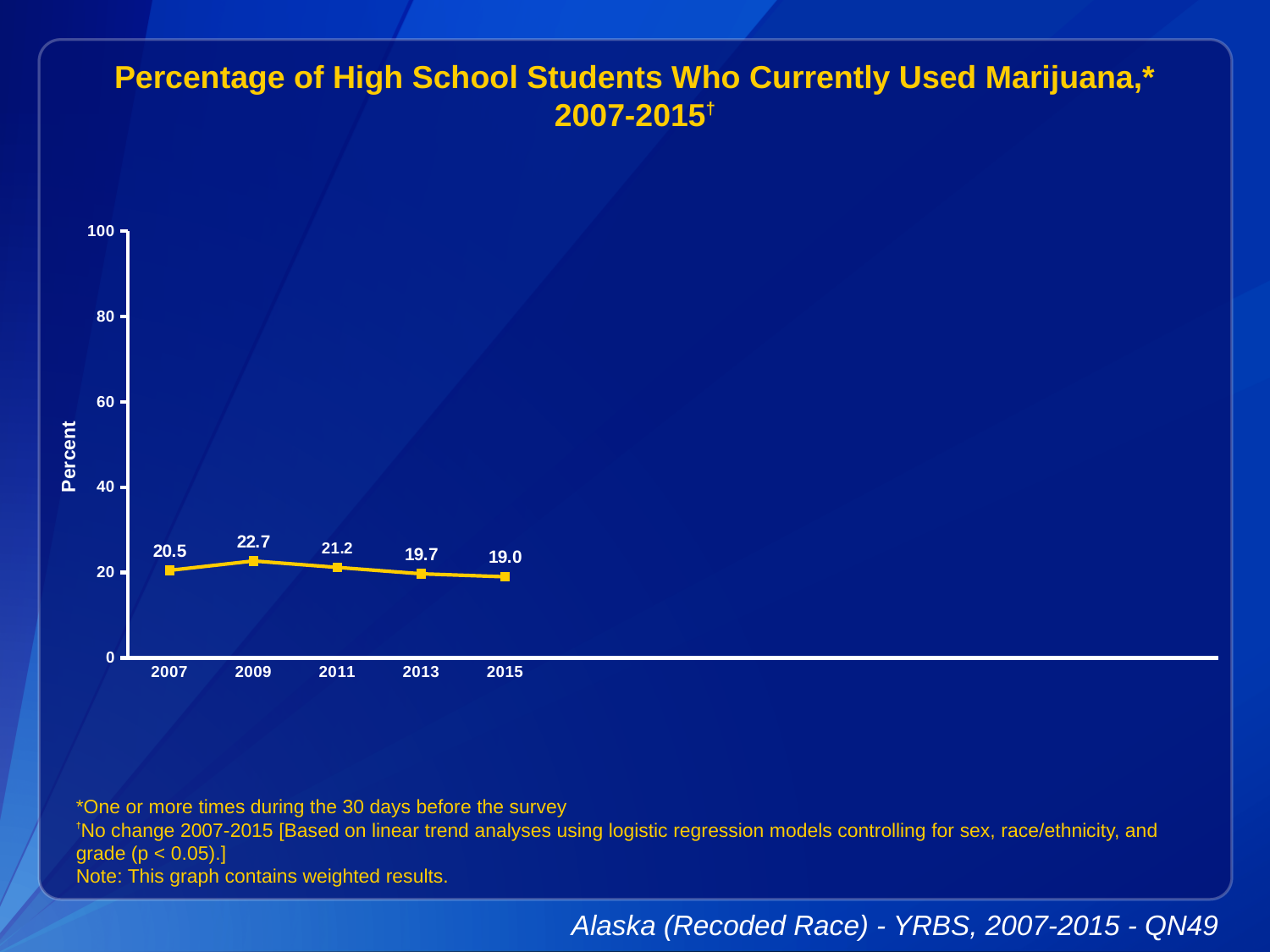
What was the percentage of high school students who currently used marijuana in 2007? 20.5 What is the label on the y axis? Percent What kind of chart is shown? line chart Is the value for 2009 greater or less than 40? less Which year has the lowest percentage? 2015 How many years are plotted on the chart? 5 What value is shown for 2011? 21.2 Do the values rise or fall from 2009 to 2015? fall Which is larger, the value for 2007 or the value for 2013? 2007 What was the percentage of high school students who currently used marijuana in 2015? 19.0 What is the difference between the 2009 value and the 2015 value? 3.7 Which year has the highest percentage? 2009